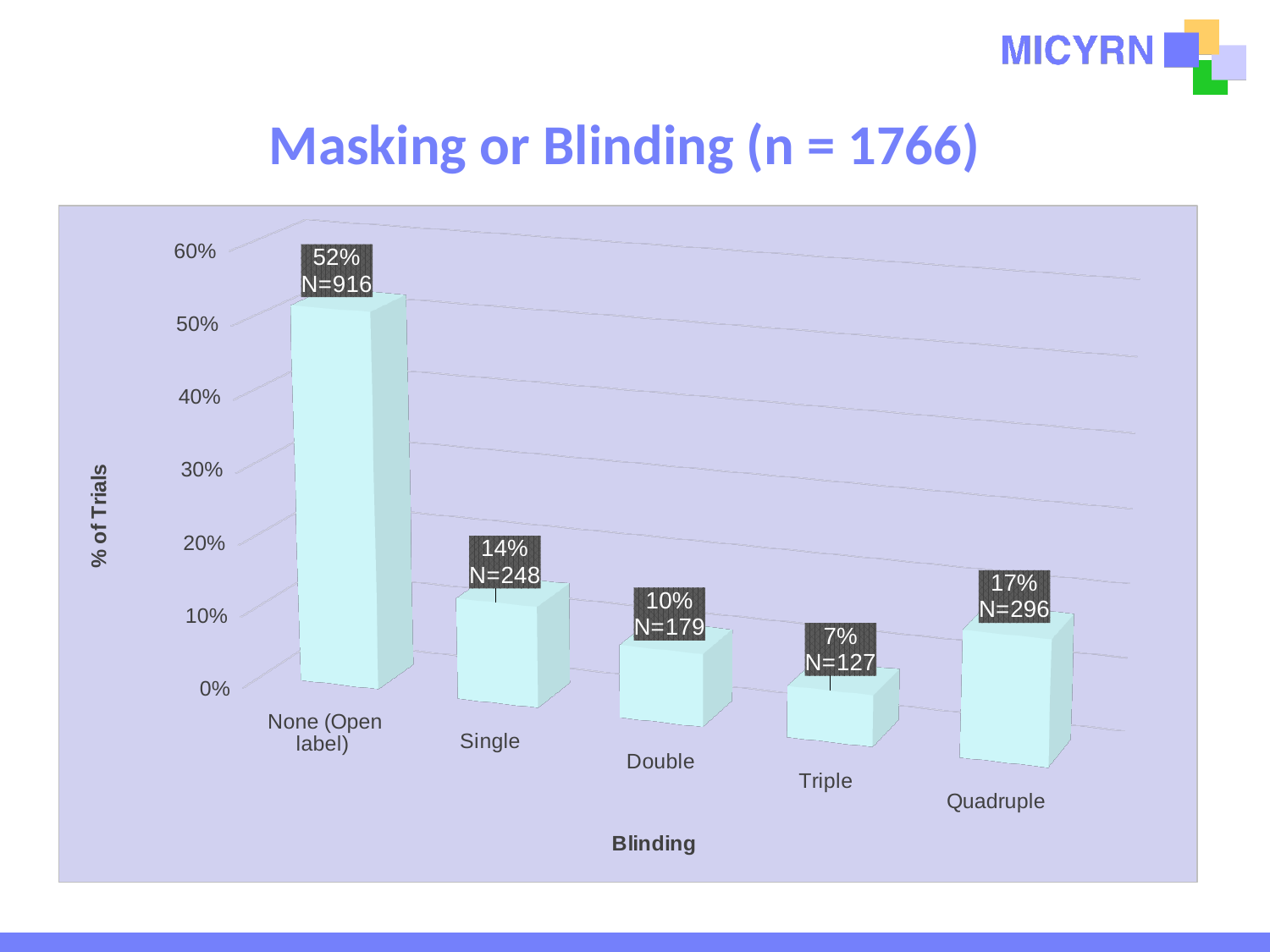
What is the title of the chart on the slide? Masking or Blinding (n = 1766) What percentage of trials were double-blinded? 10% Which blinding category has the lowest percentage of trials? Triple What kind of chart is shown on the slide? Bar chart Which blinding category has the highest percentage of trials? None (Open label) How many trials (N) were single-blinded? N=248 How many blinding categories are shown on the x axis? 5 What percentage of trials used no masking (open label)? 52% What is the difference in percentage points between Quadruple and Triple blinding? 10% What is the N value shown for Quadruple blinding? N=296 Which has a larger share of trials, Single or Quadruple blinding? Quadruple Is the value for None (Open label) greater or less than 50%? greater